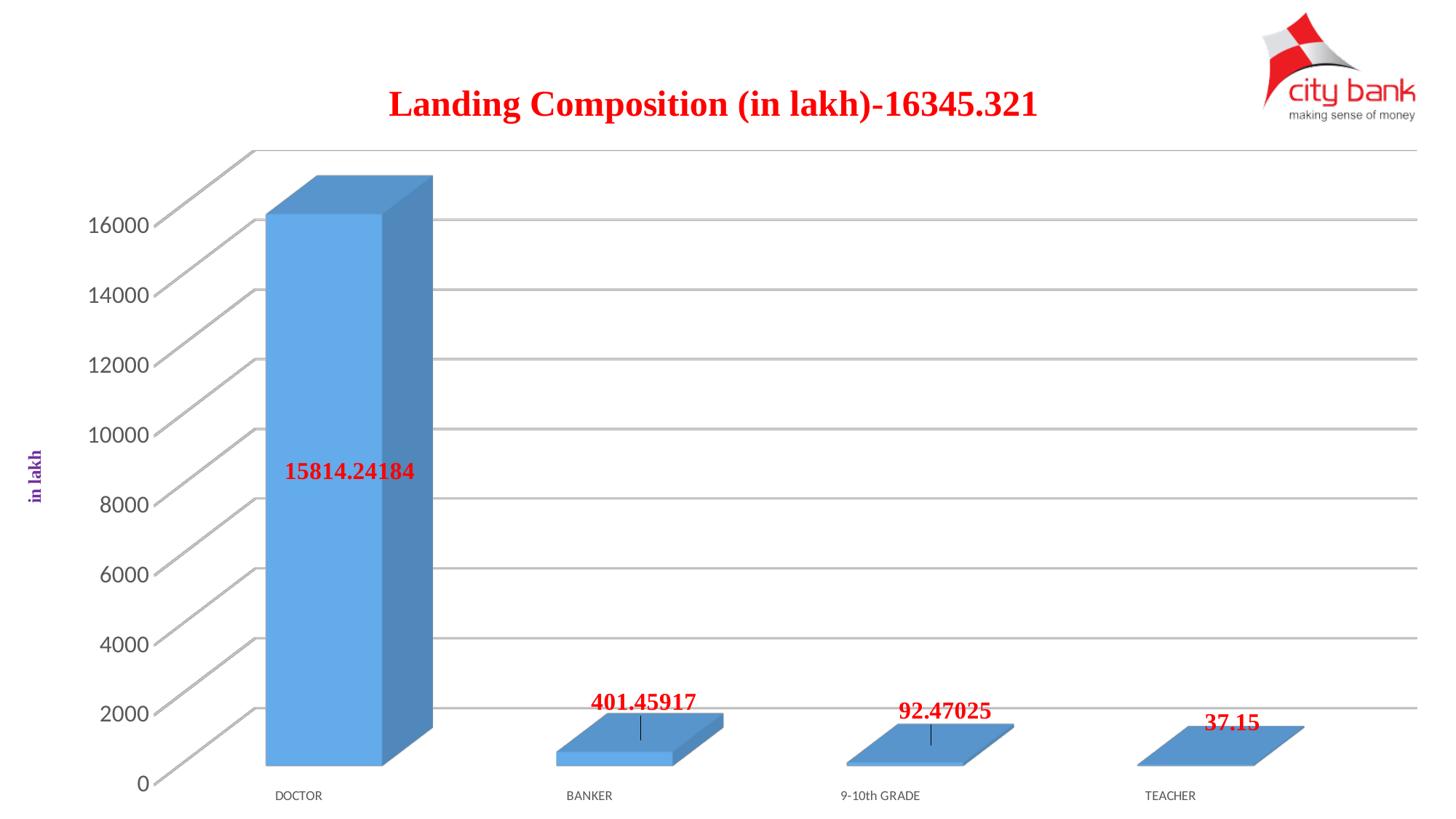
Which category has the lowest value? TEACHER What is the value for 9-10th GRADE? 92.47025 What is the difference between the values for BANKER and 9-10th GRADE? 308.98892 Which is larger, the value for BANKER or the value for TEACHER? BANKER What is the title of the chart? Landing Composition (in lakh)-16345.321 What is the value for TEACHER? 37.15 Which category has the highest value? DOCTOR What kind of chart is shown on the slide? bar chart What is the value for DOCTOR? 15814.24184 How many categories are shown on the x axis? 4 Is the value for DOCTOR greater or less than 14000? greater What is the value for BANKER? 401.45917